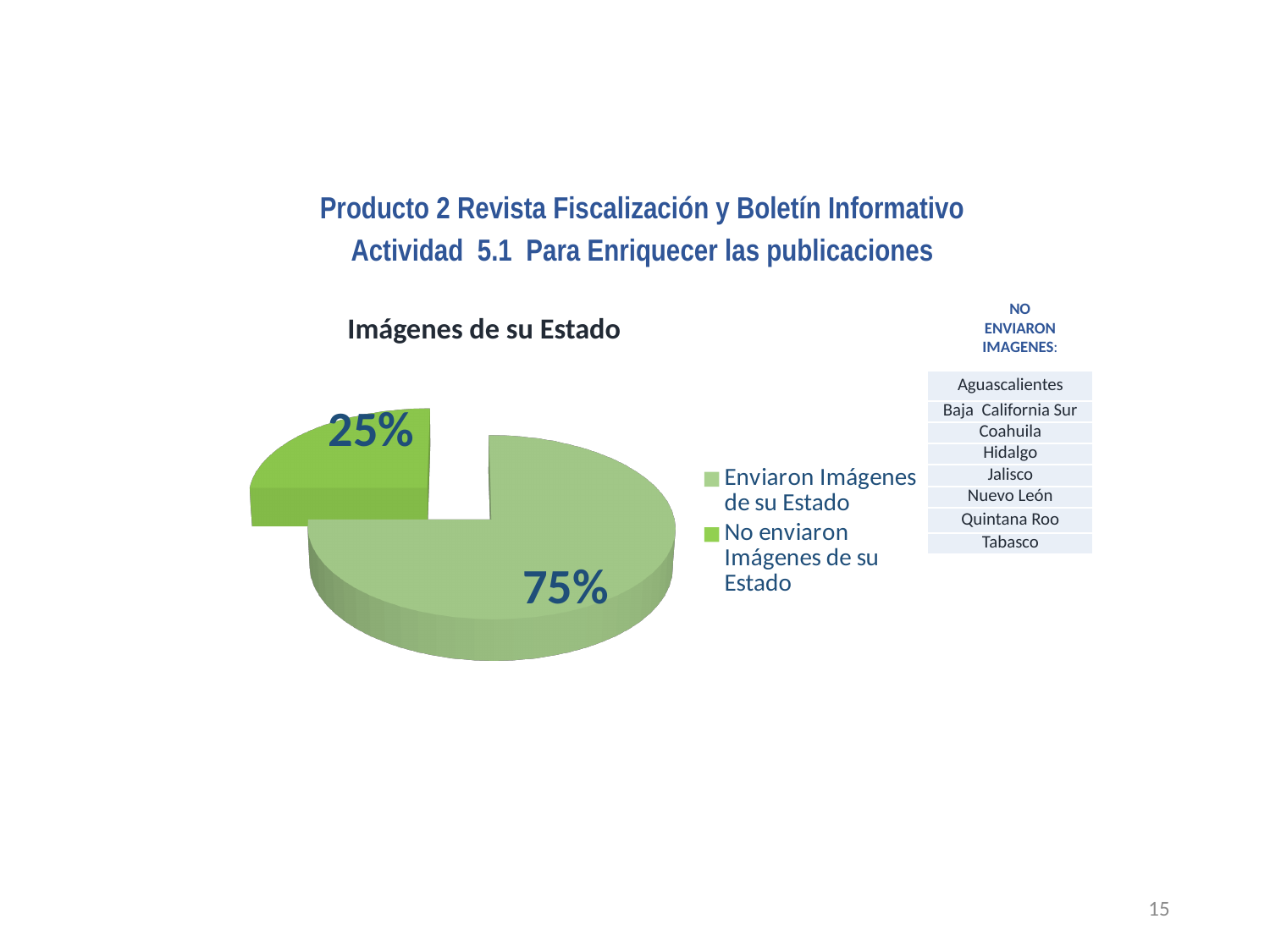
What share of the pie is labelled 'No enviaron Imágenes de su Estado'? 25% How many entries does the legend list? 2 What share of the pie is labelled 'Enviaron Imágenes de su Estado'? 75% What is the title of the chart? Imágenes de su Estado Is the share for 'No enviaron Imágenes de su Estado' greater or less than 50%? less How many states are listed in the table under 'NO ENVIARON IMAGENES'? 8 Which slice is the largest? Enviaron Imágenes de su Estado Which is larger: the 'Enviaron Imágenes de su Estado' slice or the 'No enviaron Imágenes de su Estado' slice? Enviaron Imágenes de su Estado Which slice is the smallest? No enviaron Imágenes de su Estado What is the difference in percentage points between the 'Enviaron' and 'No enviaron' slices? 50 What kind of chart is shown on the slide? Pie chart How many slices does the pie chart have? 2